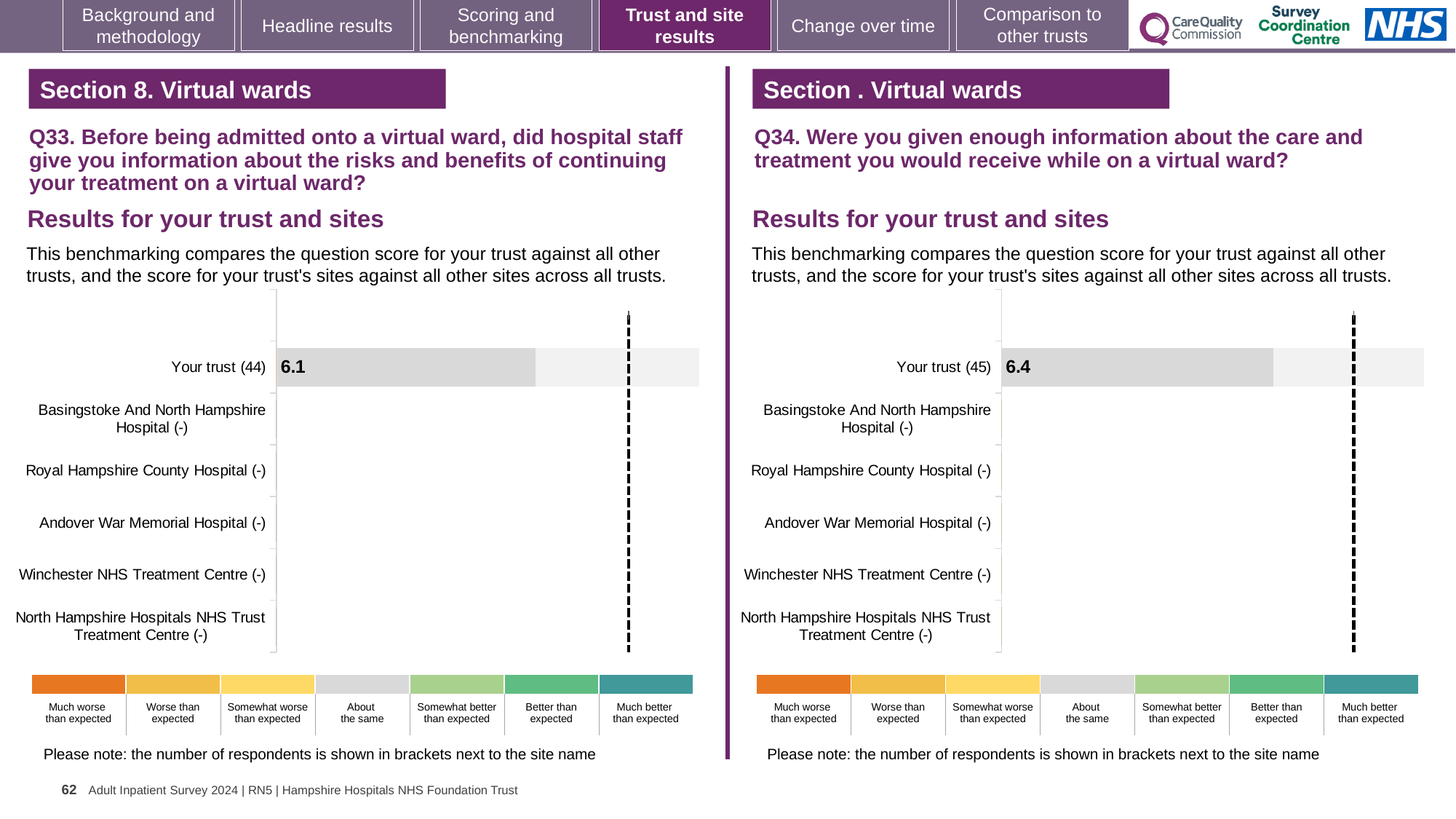
In the Q34 chart on the right, how many respondents are shown in brackets next to Your trust? 45 In the legend below the Q33 chart, which category is shown in orange at the far left? Much worse than expected Which chart shows a higher score for Your trust, the Q33 chart on the left or the Q34 chart on the right? Q34 chart on the right How many categories (rows) are listed on the y axis of the Q34 chart on the right? 6 What is the difference between the Your trust score in the Q34 chart and the Your trust score in the Q33 chart? 0.3 In the Q33 chart on the left, how many rows have a bar plotted? 1 In the Q33 chart on the left, what is the score for Your trust? 6.1 How many benchmark categories does the colour legend below the Q33 chart list? 7 What kind of chart is used in the Q33 chart on the left? Bar chart In the Q34 chart on the right, what is the score for Your trust? 6.4 In the Q34 chart on the right, which category is listed last on the y axis? North Hampshire Hospitals NHS Trust Treatment Centre (-) In the Q33 chart on the left, how many respondents are shown in brackets next to Your trust? 44